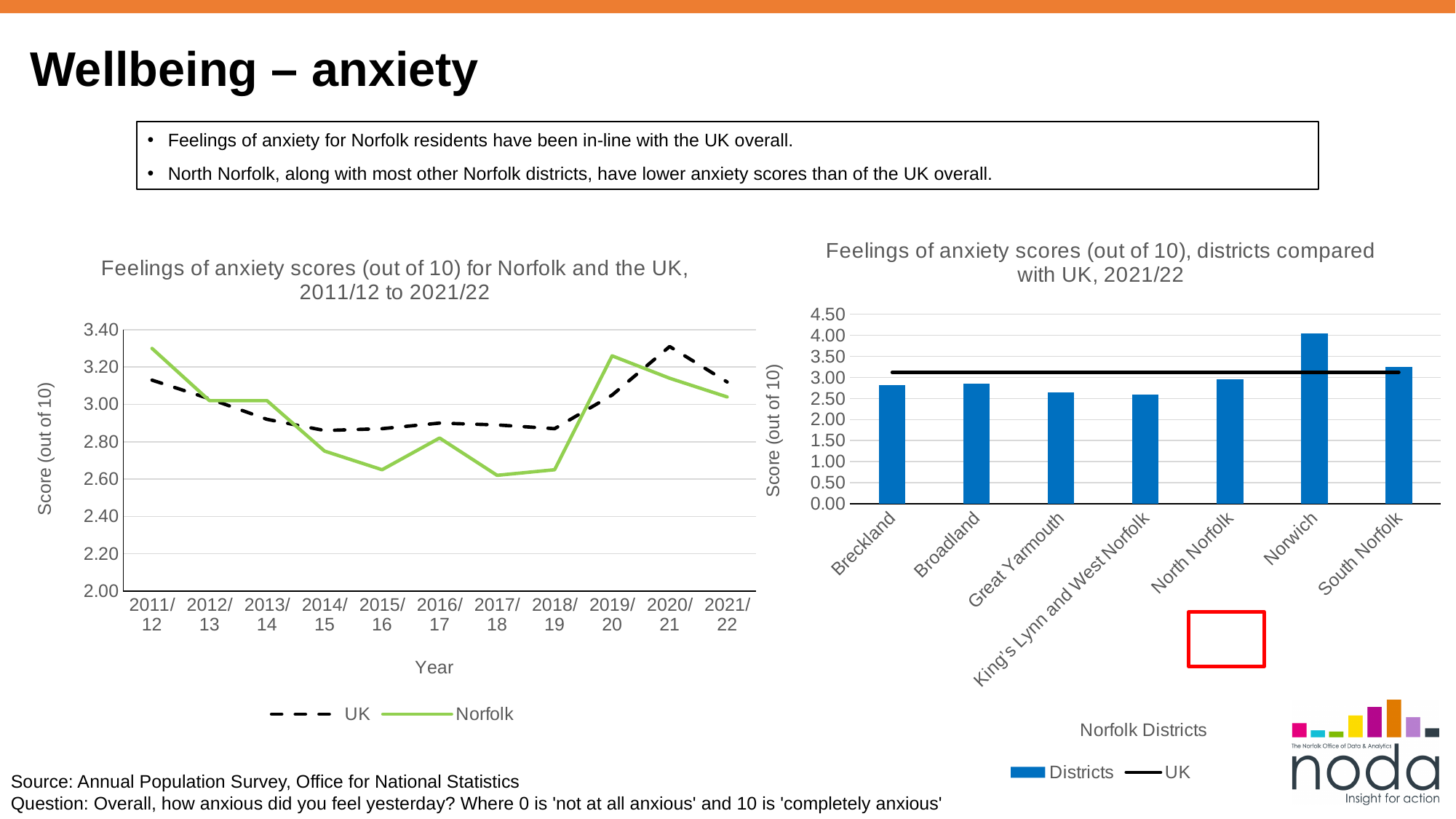
In the left chart, in which year is the UK score highest? 2020/21 In the left chart, is the Norfolk score for 2017/18 greater or less than 2.80? less What kind of chart is the left chart, 'Feelings of anxiety scores (out of 10) for Norfolk and the UK, 2011/12 to 2021/22'? line chart In the right chart, is the value for Breckland greater or less than 3.00? less In the right chart, which district has the highest anxiety score? Norwich In the right chart, how many Norfolk districts are shown? 7 In the left chart, is the UK score for 2020/21 greater or less than 3.20? greater In the left chart, does the Norfolk score rise or fall from 2011/12 to 2015/16? fall In the left chart, how many series does the legend list? 2 In the left chart, how many years are shown on the x axis? 11 In the left chart, which is higher in 2019/20, the UK score or the Norfolk score? Norfolk What kind of chart is the right chart, 'Feelings of anxiety scores (out of 10), districts compared with UK, 2021/22'? bar chart